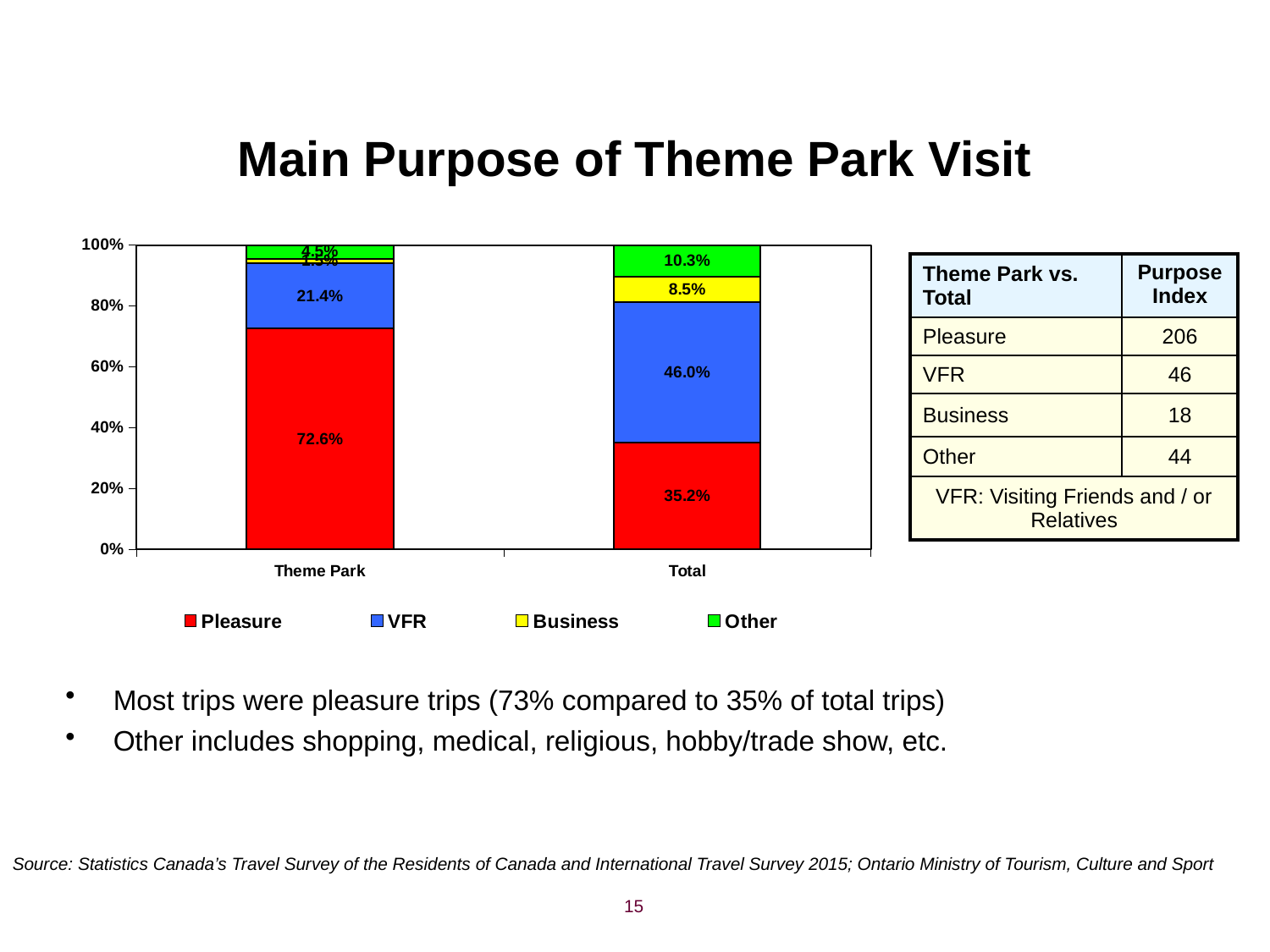
What is the Pleasure share for Total? 35.2% What is the Pleasure share for Theme Park? 72.6% What is the VFR share for Total? 46.0% What is the Business share for Total? 8.5% What is the VFR share for Theme Park? 21.4% What is the Other share for Total? 10.3% How many series does the legend list? 4 Which has the larger VFR share, Theme Park or Total? Total How many bars (categories) are shown on the x axis? 2 How many percentage points higher is the Pleasure share for Theme Park than for Total? 37.4 percentage points Which purpose has the largest share in the Total bar? VFR What kind of chart is shown on the slide? Stacked bar chart